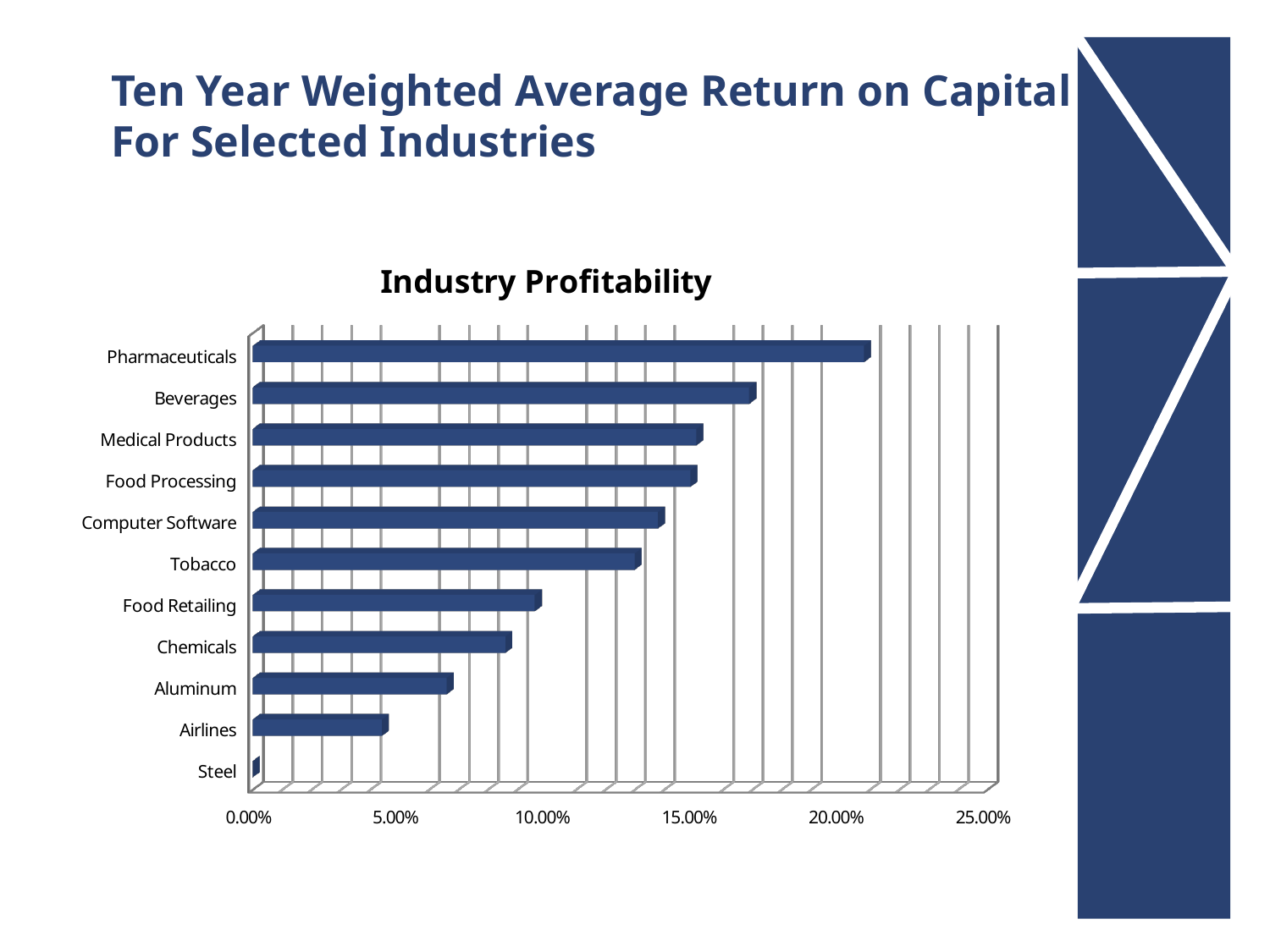
How many industries are plotted in the chart? 11 Which has a higher return on capital, Beverages or Tobacco? Beverages What type of chart is shown on the slide? Bar chart Which has a higher return on capital, Aluminum or Airlines? Aluminum Is the value for Tobacco greater or less than 10.00%? greater Is the value for Pharmaceuticals greater or less than 20.00%? greater Is the value for Beverages greater or less than 15.00%? greater Which industry has the highest return on capital? Pharmaceuticals What is the title of the chart? Industry Profitability Which industry has the lowest return on capital? Steel